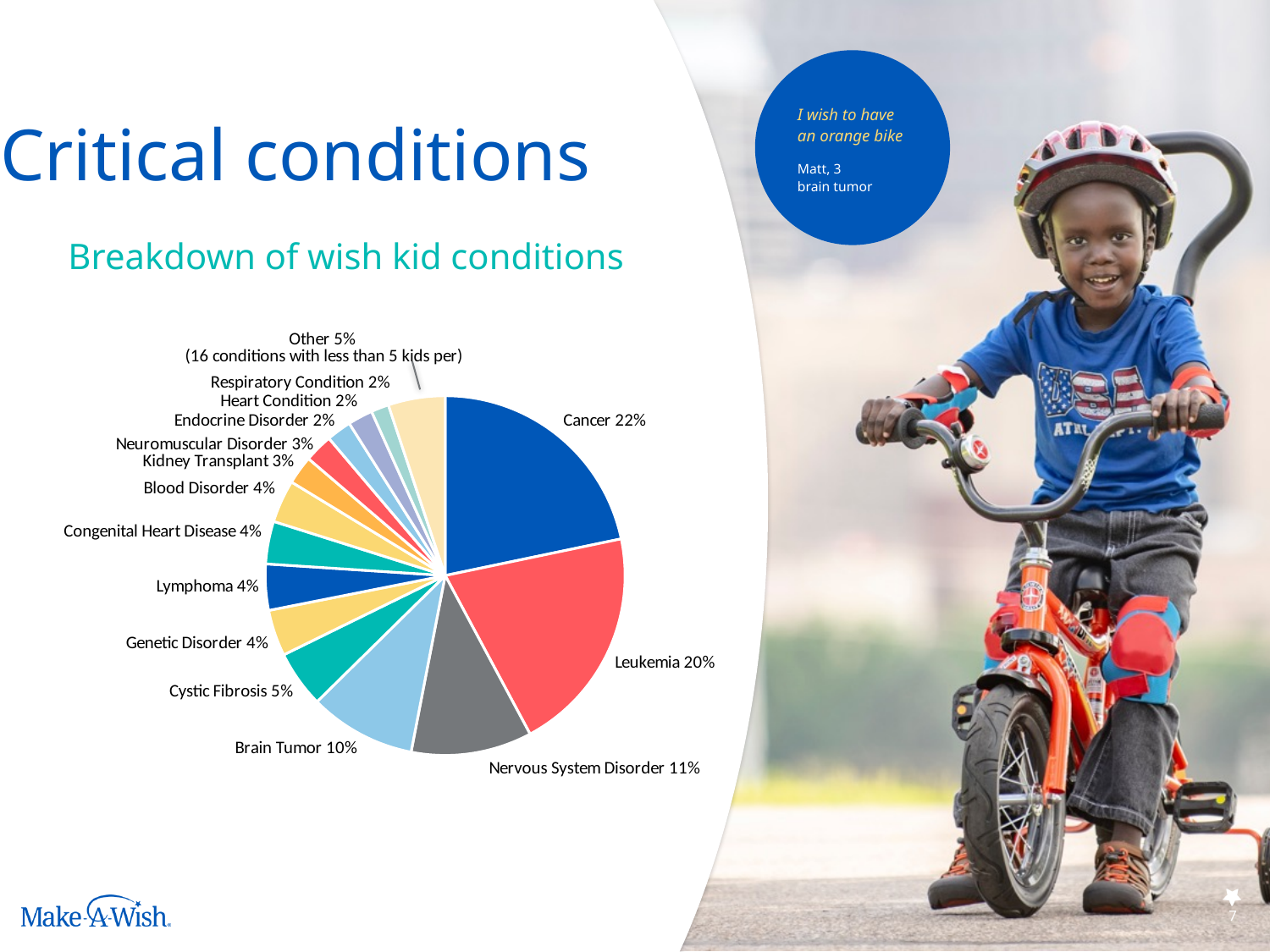
What percentage is shown for Kidney Transplant? 3% What percentage of the pie is Leukemia? 20% How many slices does the pie chart have? 15 What is the difference in percentage points between Cancer and Leukemia? 2% What is the subtitle shown above the pie chart? Breakdown of wish kid conditions Which is larger, the share for Brain Tumor or the share for Cystic Fibrosis? Brain Tumor What is the value shown for Nervous System Disorder? 11% What share of wish kid conditions is Cancer? 22% What kind of chart is shown on the slide? pie chart What percentage is shown for Brain Tumor? 10% What percentage is shown for the Other category? 5% Which condition has the largest share of the pie? Cancer